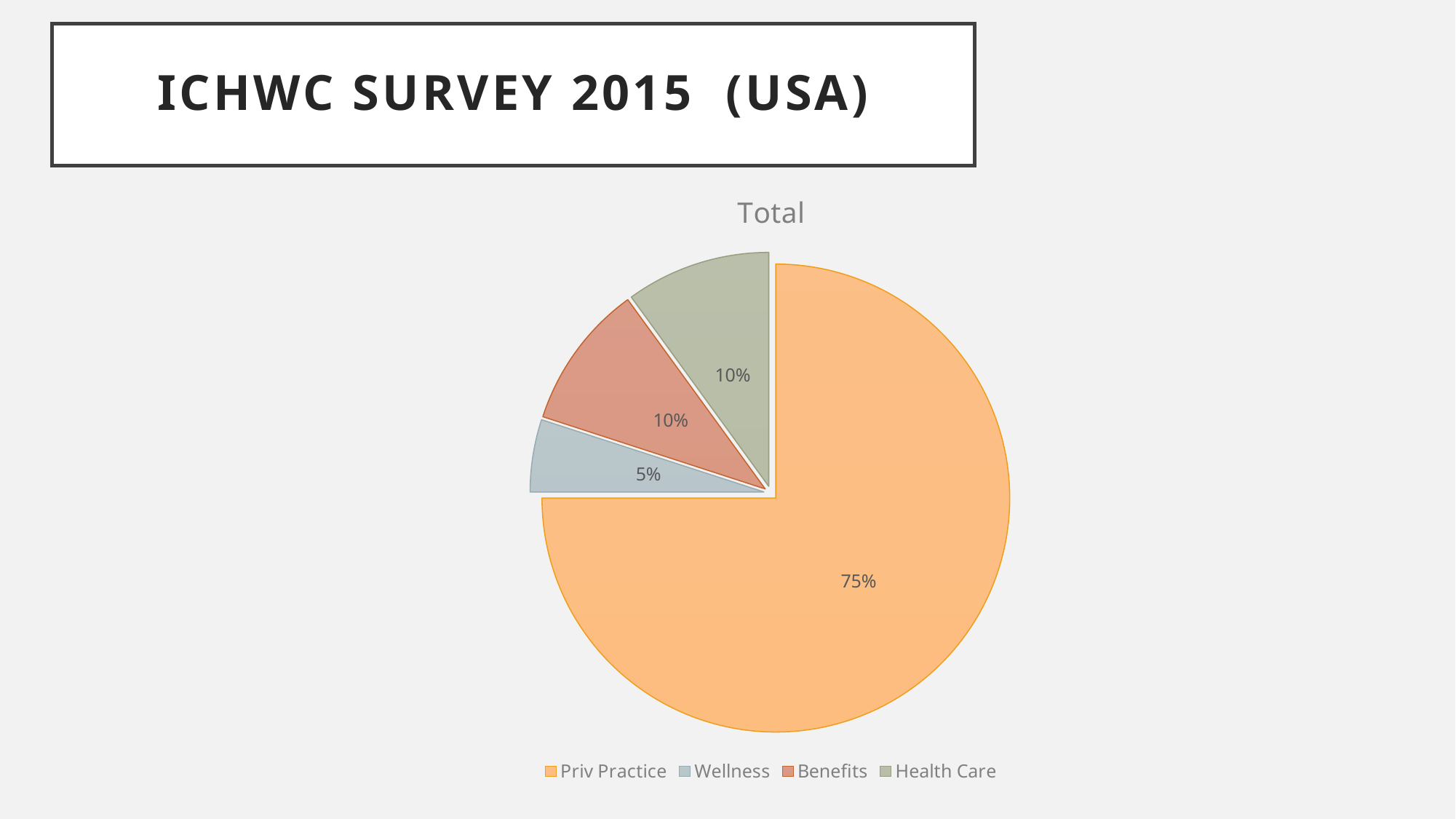
What share of the pie does Health Care have? 10% What share of the pie does Wellness have? 5% What is the difference between the Priv Practice share and the Wellness share? 70% How many categories does the pie chart show? 4 What kind of chart is shown on the slide? pie chart What share of the pie does Benefits have? 10% Which category has the smallest slice of the pie? Wellness Which category has the largest slice of the pie? Priv Practice Which category is shown in orange in the legend? Priv Practice Which is larger, the Benefits slice or the Wellness slice? Benefits What is the chart's title? Total